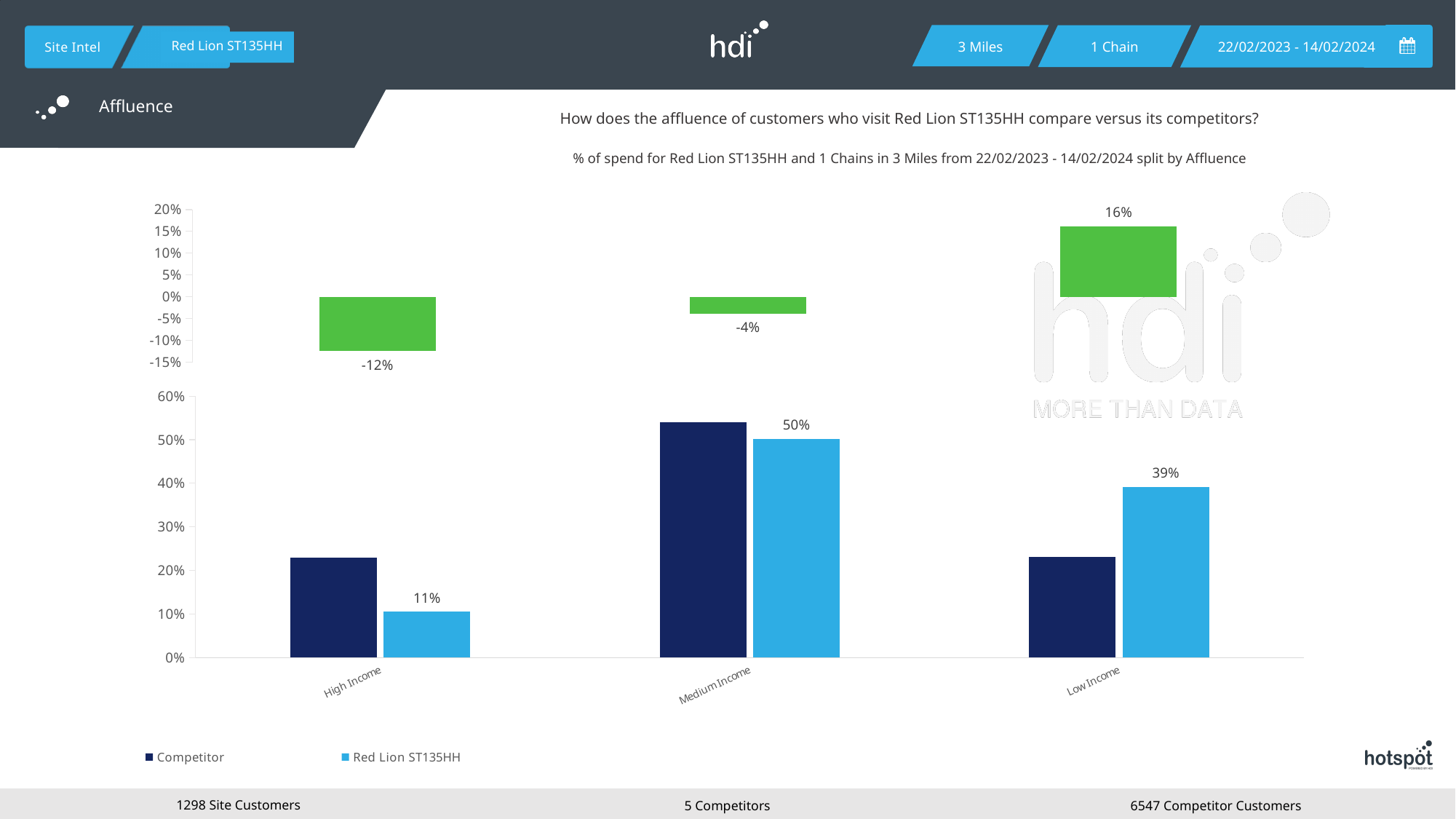
How many series does the legend of the bottom bar chart list? 2 What type of chart is the bottom chart? Bar chart In the bottom bar chart, which is larger for Low Income: the Competitor value or the Red Lion ST135HH value? Red Lion ST135HH In the bottom bar chart, what is the difference between the Red Lion ST135HH values for Medium Income and Low Income? 11% In the top difference chart, what is the value shown for High Income? -12% In the bottom bar chart, is the Competitor value for Medium Income greater or less than 50%? greater In the bottom bar chart, what is the value for Red Lion ST135HH in the Low Income category? 39% In the bottom bar chart, what is the value for Red Lion ST135HH in the High Income category? 11% In the top difference chart, which category has the lowest value? High Income In the bottom bar chart, what is the value for Red Lion ST135HH in the Medium Income category? 50% In the bottom bar chart, which category has the highest value for Red Lion ST135HH? Medium Income In the top difference chart, what is the value shown for Low Income? 16%